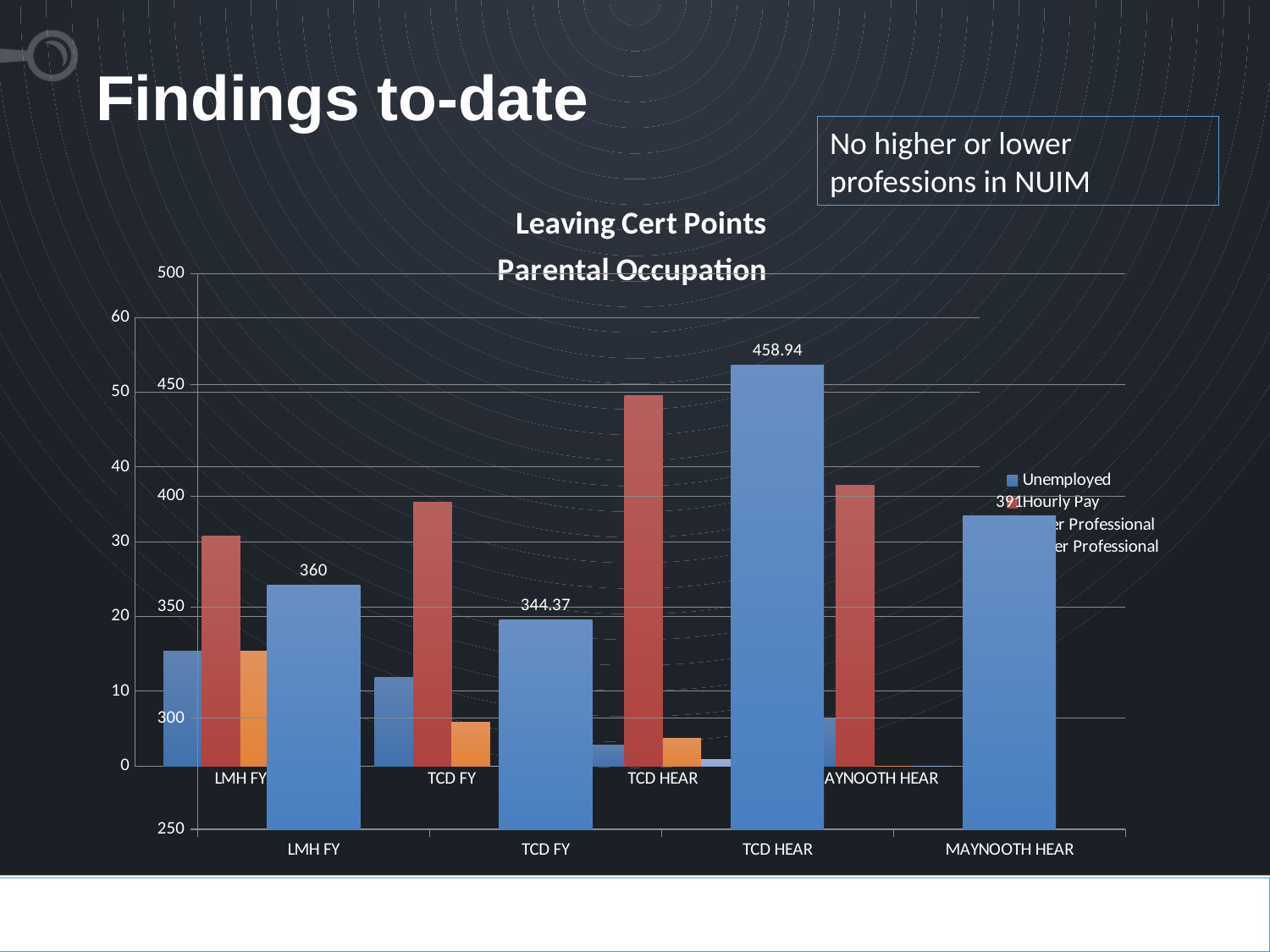
In the Leaving Cert Points chart, which is larger: the value for LMH FY or the value for MAYNOOTH HEAR? MAYNOOTH HEAR In the Leaving Cert Points chart, which category has the lowest value? TCD FY In the Leaving Cert Points chart, what is the value for TCD FY? 344.37 What kind of chart is the Leaving Cert Points chart? bar chart In the Leaving Cert Points chart, what is the value for MAYNOOTH HEAR? 391 In the Leaving Cert Points chart, what is the value for TCD HEAR? 458.94 In the Parental Occupation chart, is the Unemployed value for LMH FY greater or less than 10? greater In the Leaving Cert Points chart, what is the value for LMH FY? 360 In the Leaving Cert Points chart, which category has the highest value? TCD HEAR In the Leaving Cert Points chart, what is the difference between the values for LMH FY and TCD FY? 15.63 How many categories are shown on the x axis of the Leaving Cert Points chart? 4 In the Leaving Cert Points chart, what is the difference between the values for TCD HEAR and TCD FY? 114.57